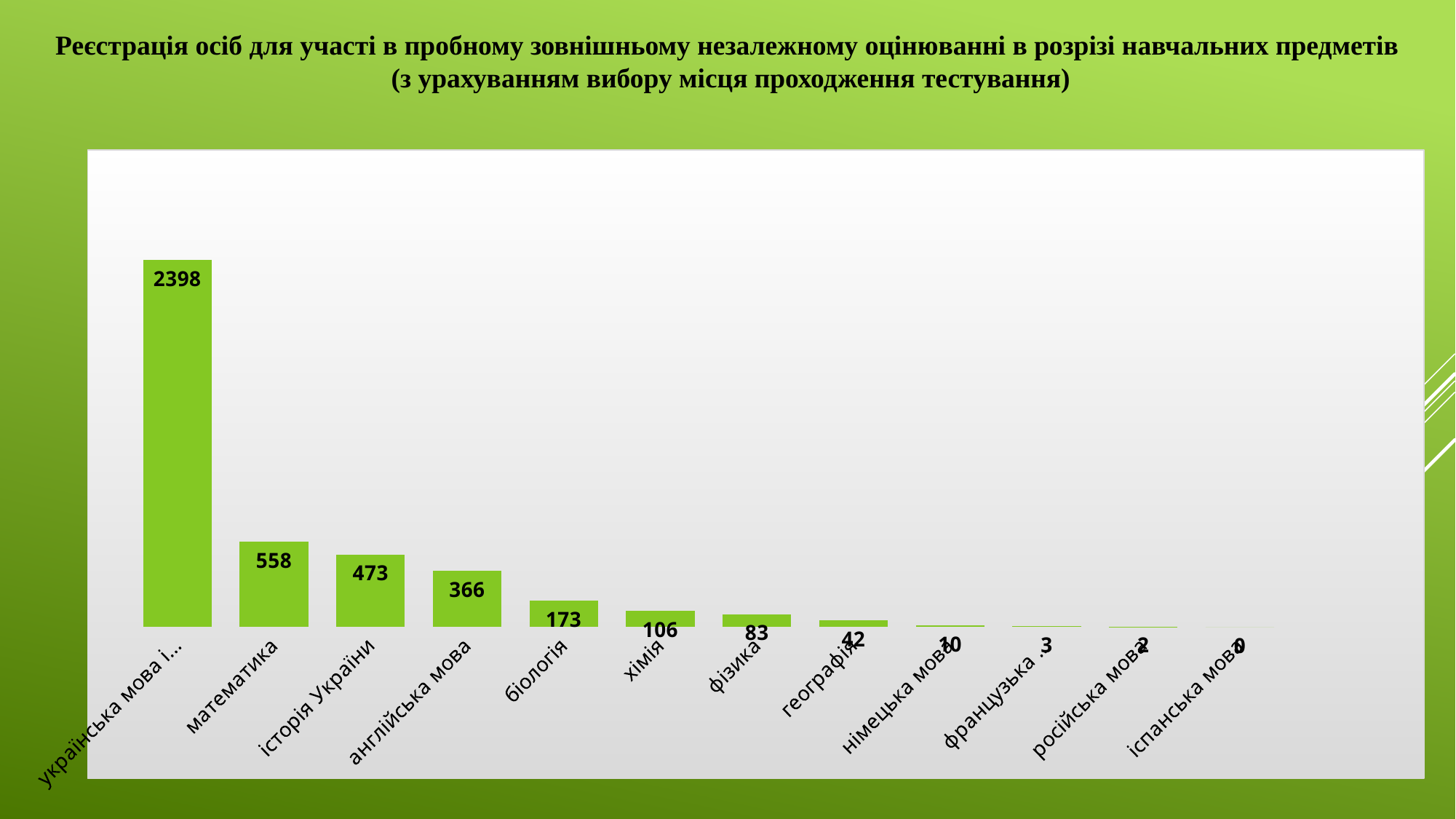
What is the difference between the values for математика and історія України? 85 What is the value for історія України? 473 What is the value for хімія? 106 Do the values rise or fall from left to right along the x axis? fall What is the difference between the values for хімія and фізика? 23 What is the value for біологія? 173 How many categories (subjects) are plotted in the chart? 12 Which subject has the highest value in the chart? українська мова і... What is the value for математика? 558 What kind of chart is shown on the slide? bar chart What is the value for англійська мова? 366 Which is larger, the value for англійська мова or the value for біологія? англійська мова